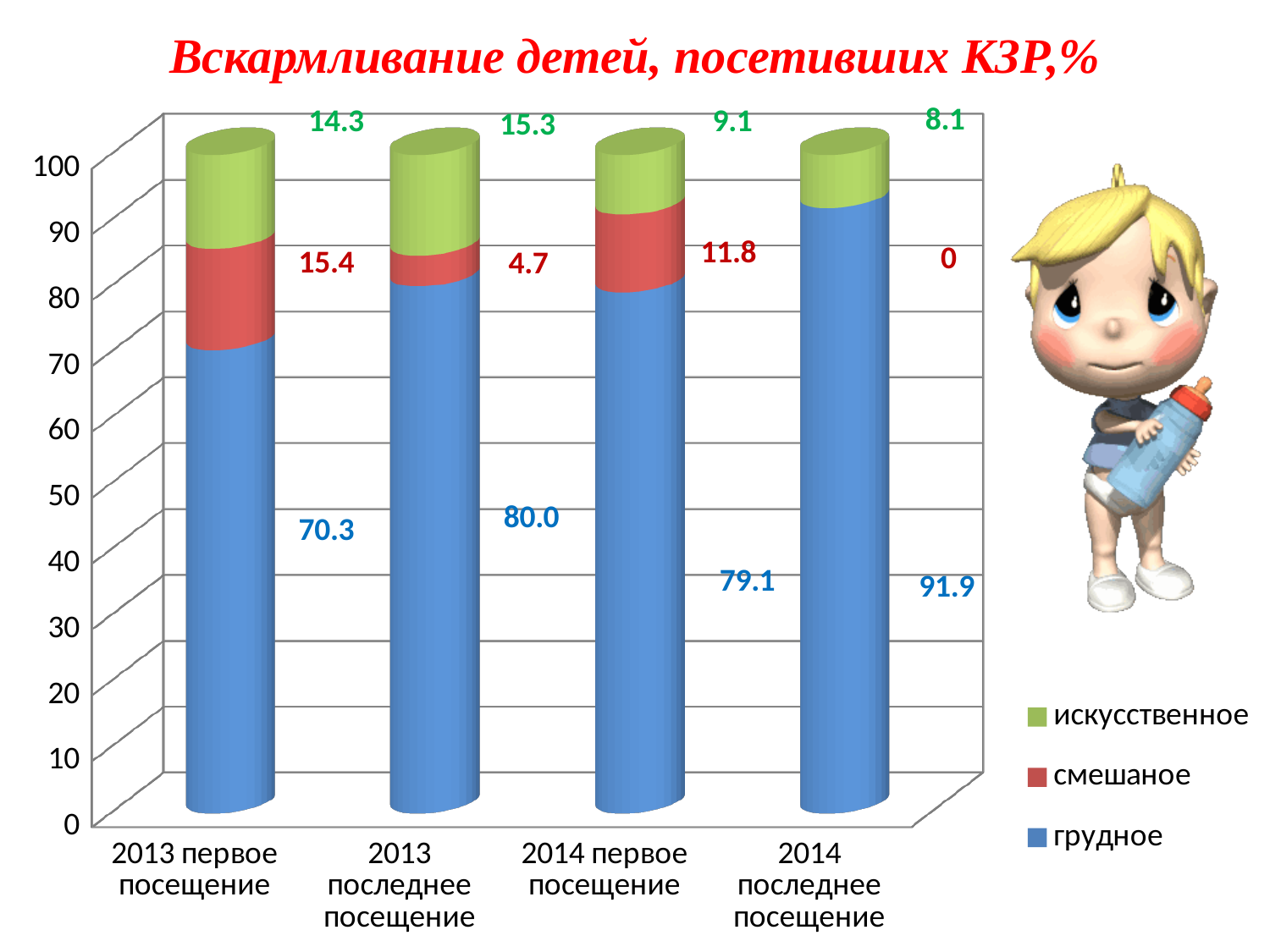
What type of chart is shown on the slide? stacked bar chart What is the value of смешаное for 2014 последнее посещение? 0 What is the value of грудное for 2013 первое посещение? 70.3 Which is larger: смешаное for 2013 первое посещение or смешаное for 2013 последнее посещение? 2013 первое посещение What is the value of искусственное for 2013 последнее посещение? 15.3 Which category has the lowest value for искусственное? 2014 последнее посещение What is the total of the stacked bar for 2014 первое посещение? 100 What is the difference between the грудное values for 2014 последнее посещение and 2013 первое посещение? 21.6 Which category has the highest value for грудное? 2014 последнее посещение How many categories are shown on the x axis? 4 How many series does the legend list? 3 What is the value of смешаное for 2014 первое посещение? 11.8